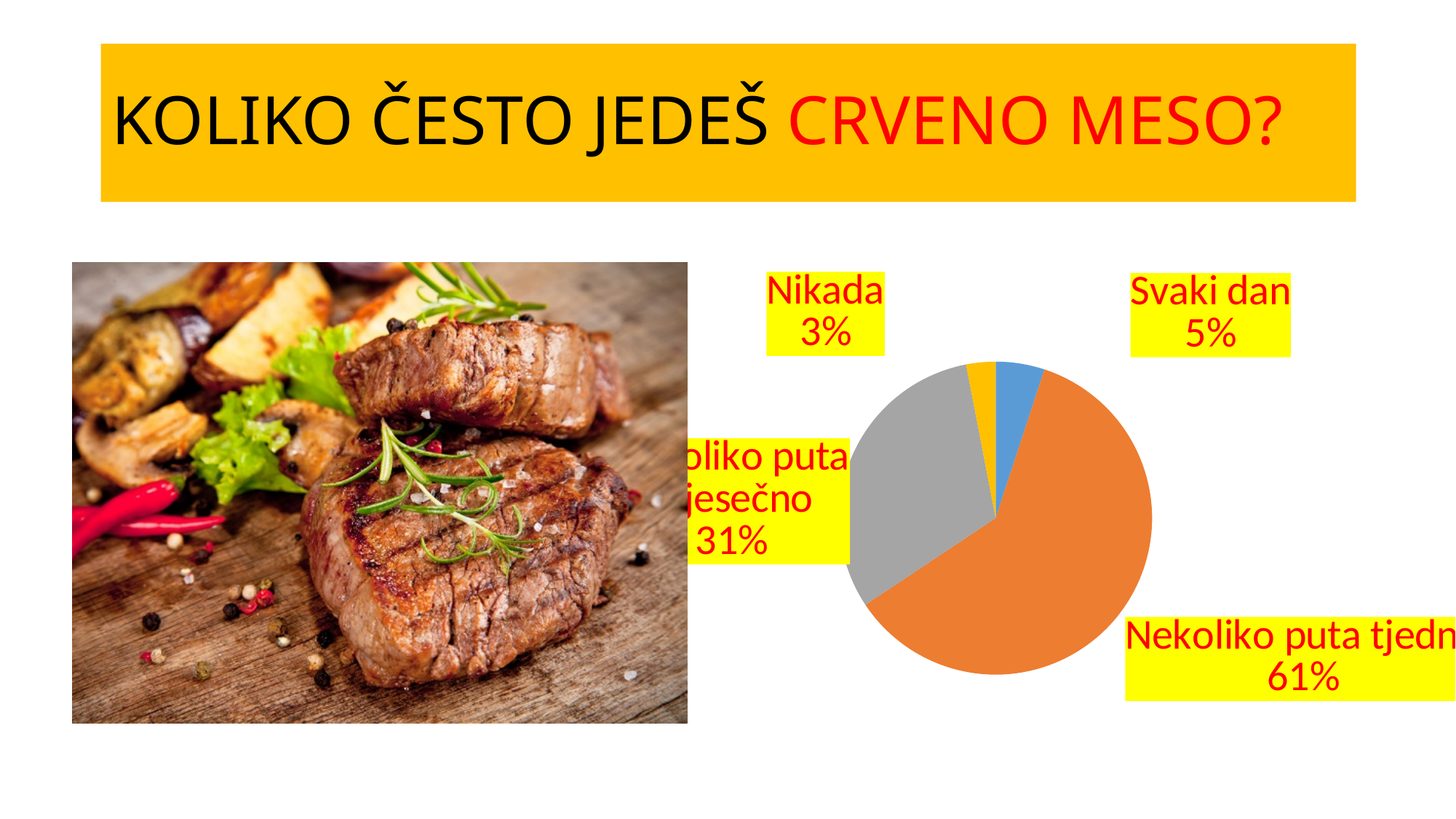
What percentage is shown for the 'Nikada' slice of the pie chart? 3% What colour is the 'Svaki dan' slice of the pie chart? blue How many percentage points larger is 'Svaki dan' than 'Nikada'? 2 What percentage does the largest slice of the pie chart show? 61% What percentage is shown for the grey slice of the pie chart? 31% Which category has the smallest slice in the pie chart? Nikada What kind of chart is shown on the slide? pie chart What colour is the largest slice of the pie chart? orange Which slice is larger, 'Svaki dan' or 'Nikada'? Svaki dan How many slices does the pie chart have? 4 What percentage is shown for the 'Svaki dan' slice of the pie chart? 5% How many percentage points larger is the largest slice (61%) than the grey slice (31%)? 30